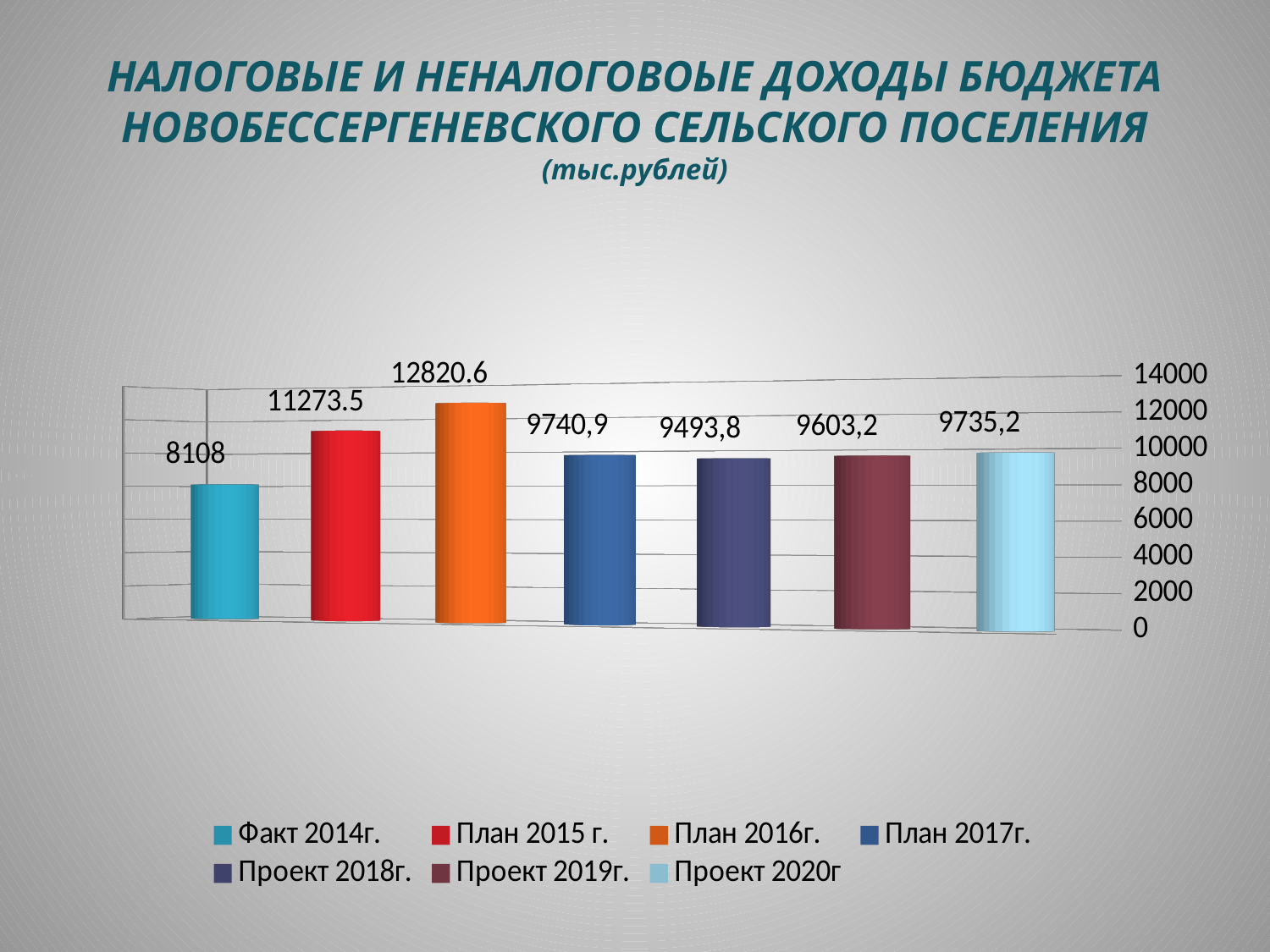
Is the value for Факт 2014г. greater or less than 10000? less What is the difference between the values for План 2017г. and Проект 2018г.? 247,1 What is the value for Факт 2014г.? 8108 Which series has the highest value? План 2016г. Which series has the lowest value? Факт 2014г. How many series does the legend list? 7 What is the value for Проект 2019г.? 9603,2 What is the difference between the values for План 2016г. and План 2015 г.? 1547.1 How many bars are plotted on the chart? 7 Which is larger, the value for Проект 2019г. or Проект 2020г? Проект 2020г What kind of chart is shown on the slide? bar chart What is the value for План 2016г.? 12820.6